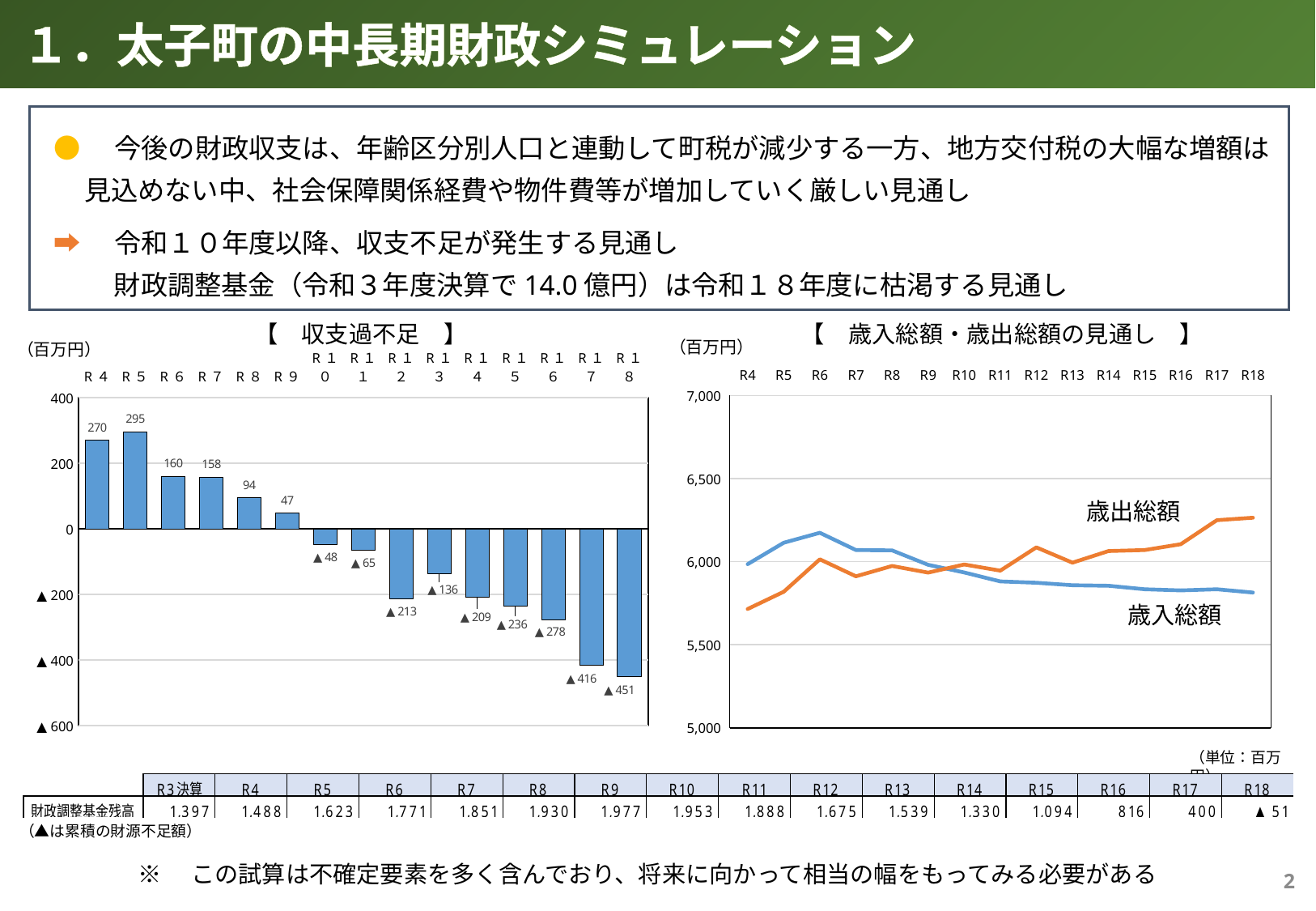
In the 収支過不足 chart on the left, what is the value for R18? ▲451 In the 歳入総額・歳出総額の見通し chart on the right, is the value of 歳出総額 at R18 greater or less than 6,000? greater In the 収支過不足 chart on the left, which year has the lowest value? R18 In the 歳入総額・歳出総額の見通し chart on the right, is the value of 歳入総額 at R18 greater or less than 6,000? less In the 収支過不足 chart on the left, what is the value for R5? 295 In the 収支過不足 chart on the left, what is the difference between the values for R4 and R5? 25 In the 収支過不足 chart on the left, do the values generally rise or fall from R4 to R18? Fall In the 収支過不足 chart on the left, how many years are plotted? 15 In the 収支過不足 chart on the left, which year has the highest value? R5 What kind of chart is the 収支過不足 chart on the left? Bar chart How many series are plotted in the 歳入総額・歳出総額の見通し chart on the right? 2 In the 収支過不足 chart on the left, which is larger, the value for R6 or the value for R8? R6